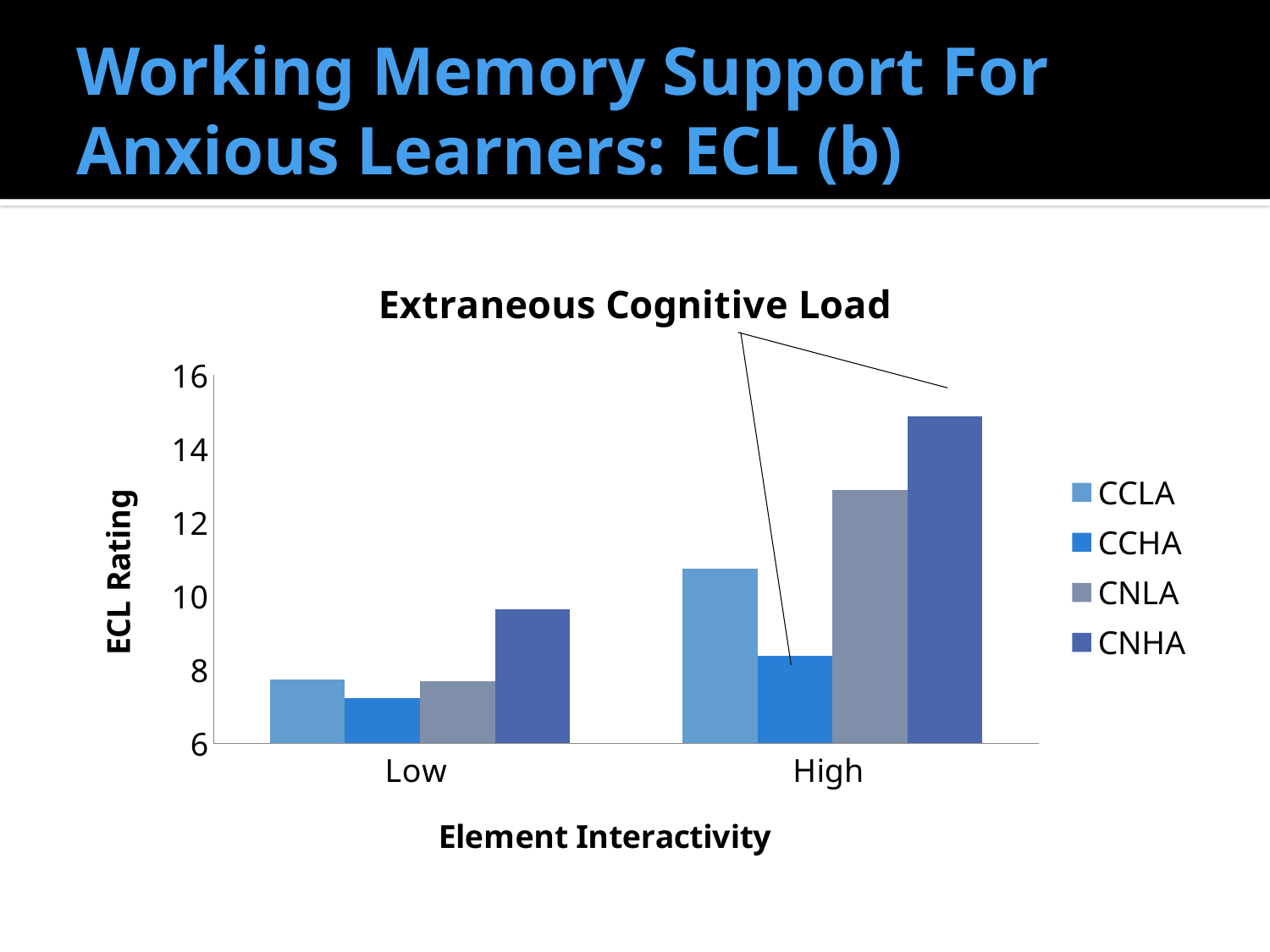
Which series has the highest bar in the Low category? CNHA Which series has the highest bar in the High category? CNHA Which is larger in the High category, CNLA or CCLA? CNLA Is the value for CCHA at High greater or less than 10? less Does the CCLA value rise or fall from Low to High element interactivity? rise How many series does the legend list? 4 What is the title of the chart? Extraneous Cognitive Load What kind of chart is shown on the slide? bar chart Is the value for CNHA at High greater or less than 14? greater What is the label of the y axis? ECL Rating Which series has the lowest bar in the Low category? CCHA How many categories are shown on the x axis? 2